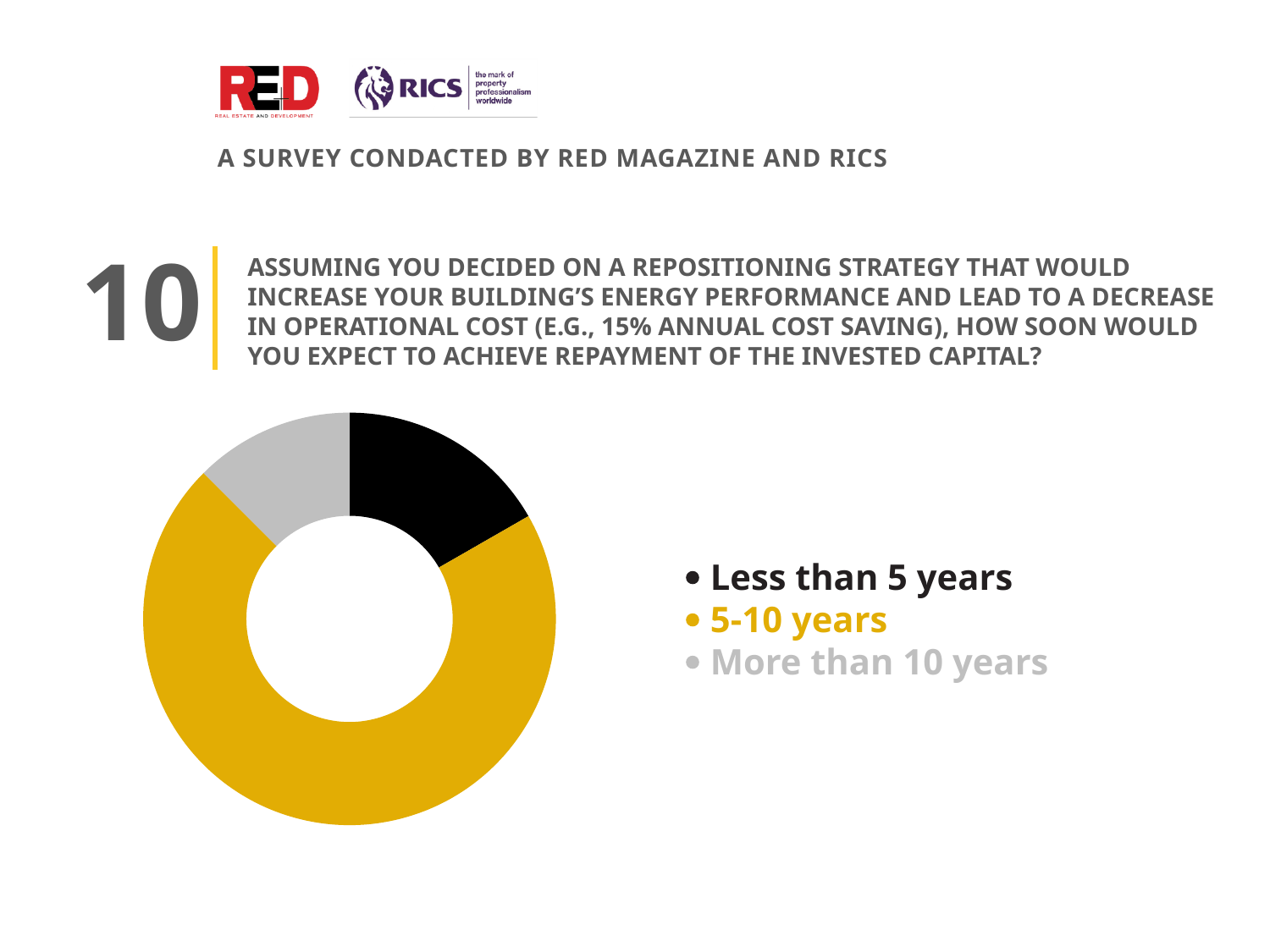
How many entries does the legend list? 3 How many categories does the donut chart show? 3 What kind of chart is shown on the slide? Donut chart What colour represents the 5-10 years category in the donut chart? Yellow Does the 5-10 years slice take up more or less than half of the donut chart? more What colour represents the Less than 5 years category in the donut chart? Black Which category has the largest share of the donut chart? 5-10 years Which is larger, the share for 5-10 years or the share for Less than 5 years? 5-10 years Which is larger, the share for 5-10 years or the share for More than 10 years? 5-10 years